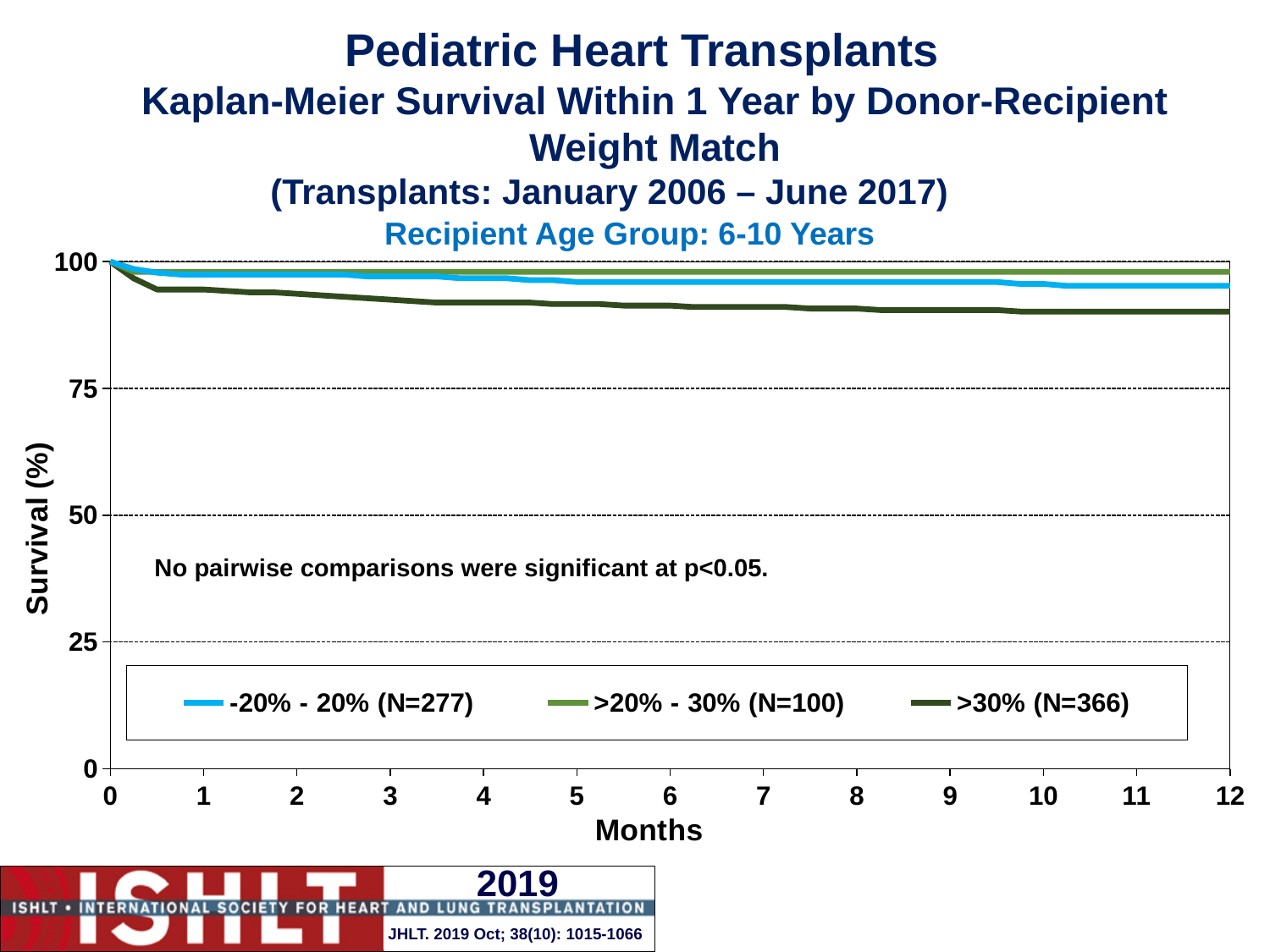
How many series does the legend list? 3 What does the note on the chart say about pairwise comparisons? No pairwise comparisons were significant at p<0.05. Is the survival value for the -20% - 20% (N=277) group at 12 months greater or less than 75? greater Do the survival curves rise or fall as months increase? Fall What kind of chart is shown on the slide? Line chart At 12 months, which has higher survival: the -20% - 20% (N=277) group or the >30% (N=366) group? -20% - 20% (N=277) Is the survival value for the >30% (N=366) group at 12 months greater or less than 50? greater Which group has the lowest survival at 12 months? >30% (N=366) Is the survival value for the >30% (N=366) group at 6 months greater or less than 100? less Which group has the highest survival at 12 months? >20% - 30% (N=100) According to the legend, how many patients are in the >30% group? 366